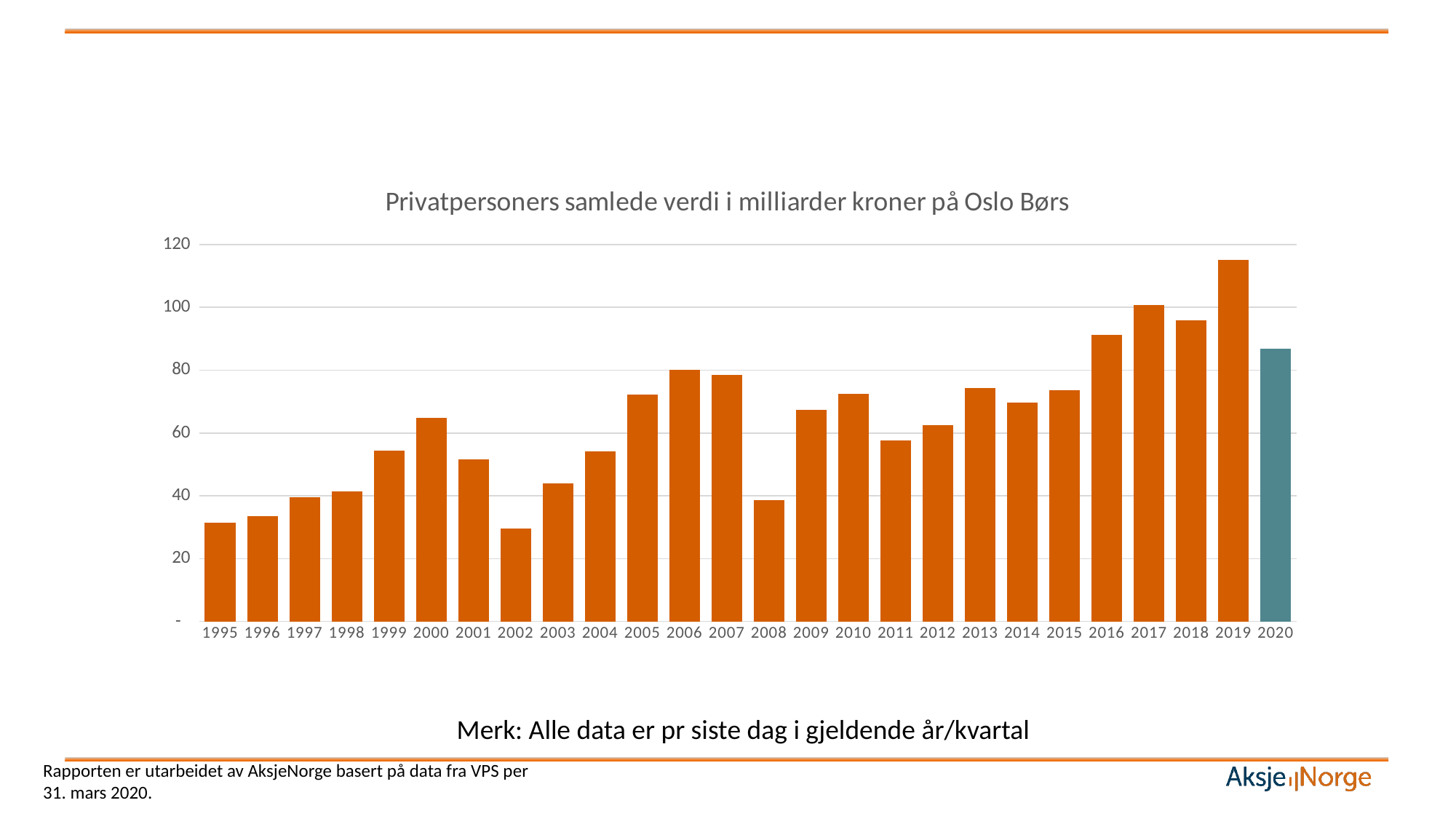
What type of chart is shown on the slide? Bar chart Which year has the larger value, 2008 or 2009? 2009 Is the value for 2020 greater or less than 80? greater Is the value for 2002 greater or less than 40? less How many years are shown on the x axis of the chart? 26 What is the title of the chart? Privatpersoners samlede verdi i milliarder kroner på Oslo Børs Which year has the highest value in the chart? 2019 Which year's bar is shown in a different colour from the others? 2020 Which year has the larger value, 2019 or 2020? 2019 Do the values rise or fall from 1995 to 2000? rise Is the value for 2019 greater or less than 100? greater